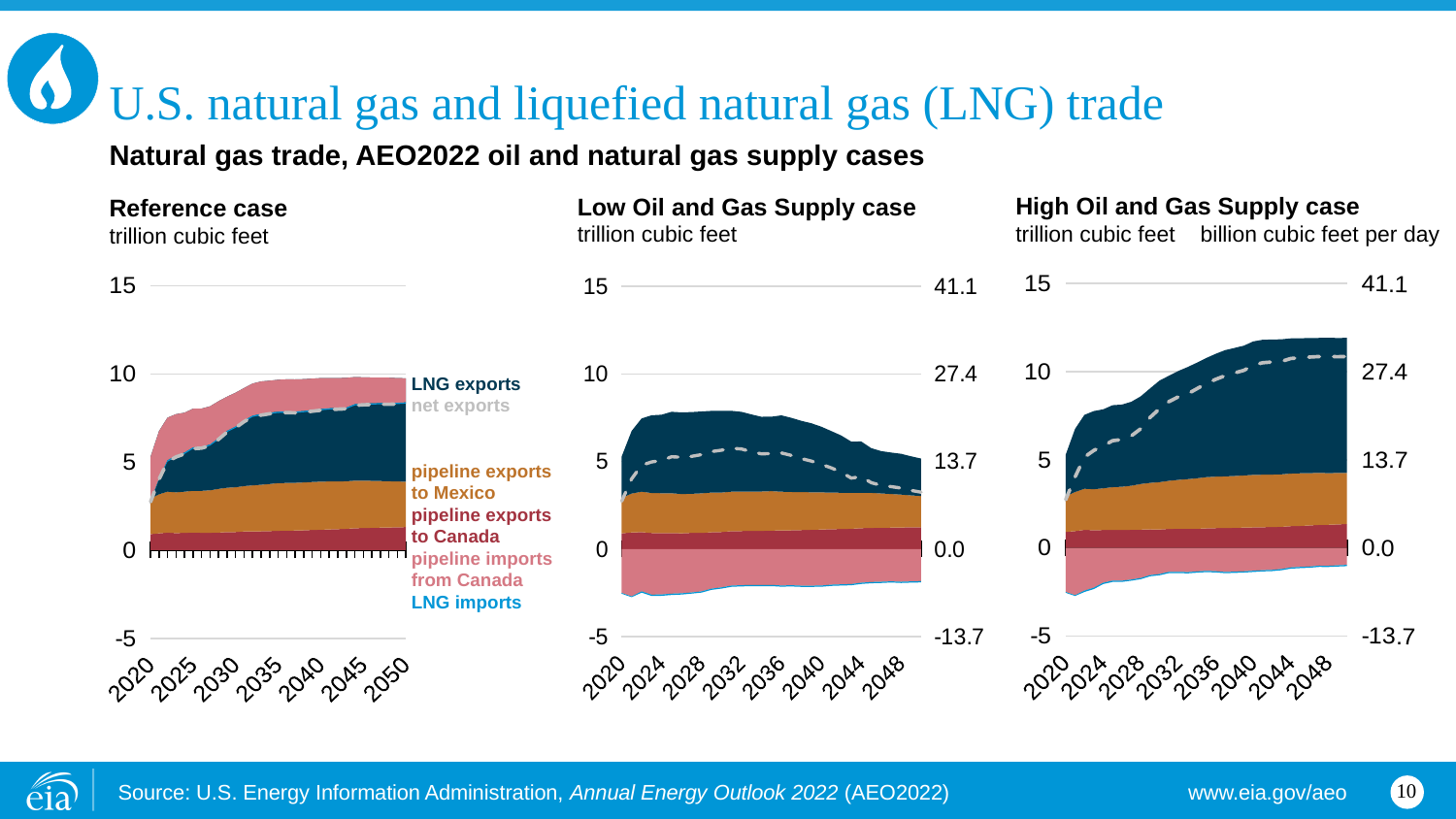
Which chart shows net exports reaching the highest level by the end of the projection: Reference case, Low Oil and Gas Supply case, or High Oil and Gas Supply case? High Oil and Gas Supply case In the High Oil and Gas Supply case chart, is the value of net exports in 2020 greater or less than 5? less On the High Oil and Gas Supply case chart, what value on the right axis (billion cubic feet per day) corresponds to 15 trillion cubic feet? 41.1 How many charts are shown on the slide? 3 In the Reference case chart, is the value of net exports in 2050 greater or less than 5? greater In the Low Oil and Gas Supply case chart, is the value of net exports in 2048 greater or less than 10? less In the High Oil and Gas Supply case chart, does net exports (dashed line) rise or fall from 2020 to 2048? rise What kind of chart is the Reference case chart? stacked area chart How many entries does the legend next to the Reference case chart list? 6 What is the title of the chart on the far left of the slide? Reference case What unit is shown on the left axis of the Reference case chart? trillion cubic feet